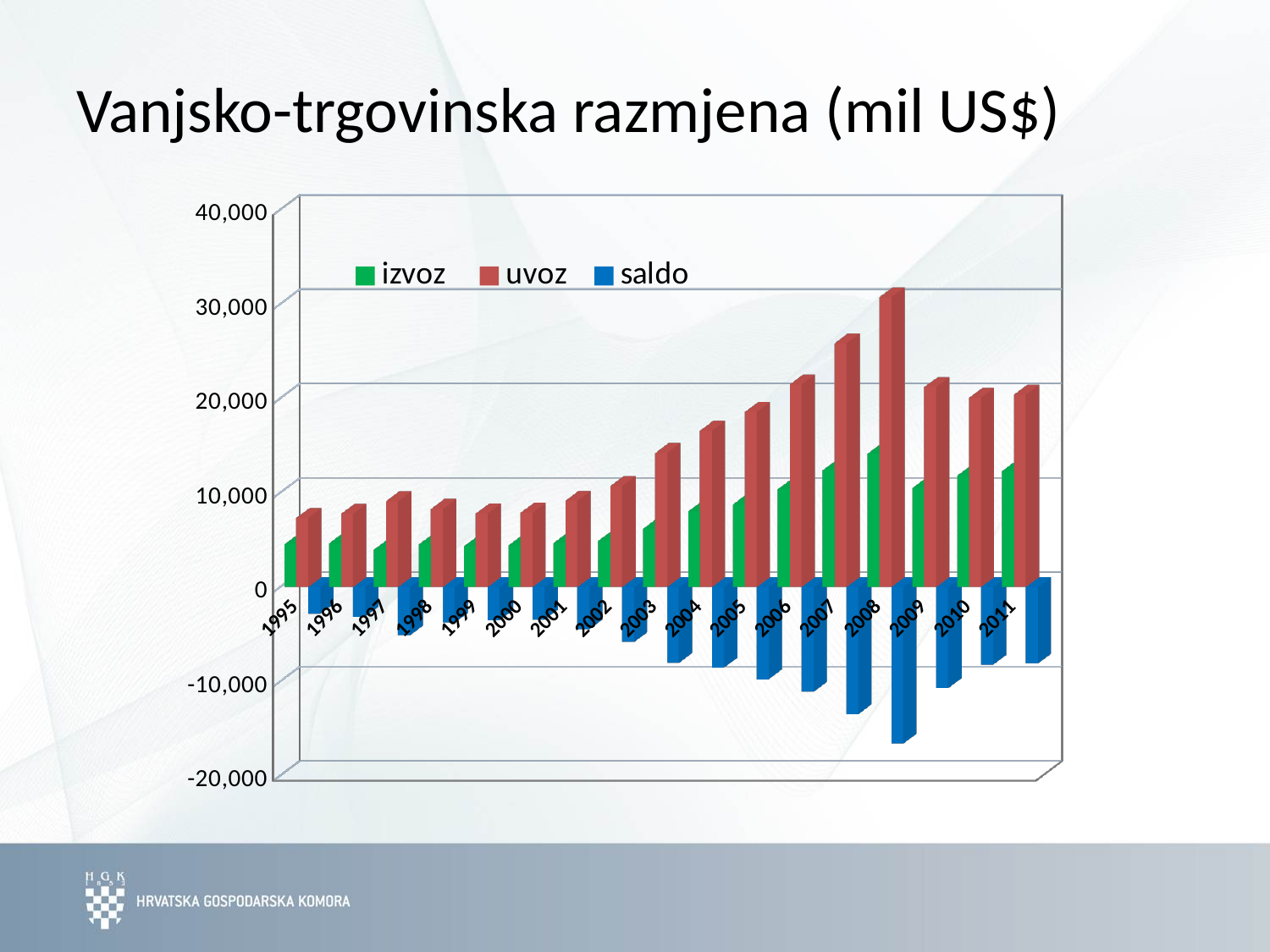
Is the value of saldo for 2008 greater or less than -10,000? less Is the value of uvoz for 2008 greater or less than 20,000? greater In which year is uvoz the highest? 2008 How many series does the legend list? 3 How many years are shown on the x axis? 17 In which year is saldo the lowest (most negative)? 2008 What is the title of the chart? Vanjsko-trgovinska razmjena (mil US$) Does uvoz generally rise or fall from 1995 to 2008? rise Is the value of izvoz for 2008 greater or less than 10,000? greater What kind of chart is shown on the slide? bar chart Which is larger, uvoz in 2007 or uvoz in 2009? uvoz in 2007